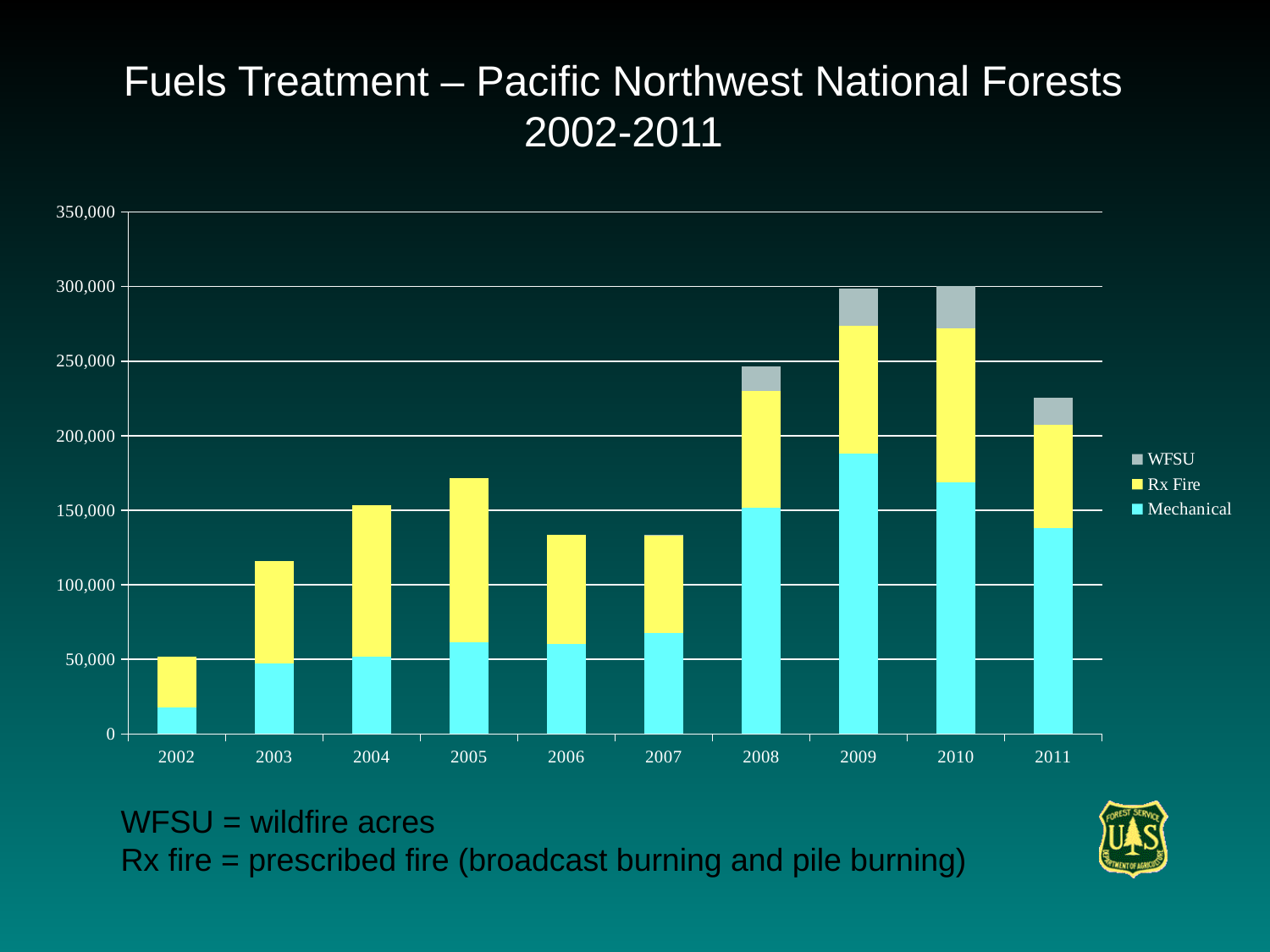
Is the total bar for 2008 greater or less than 200,000? greater Which year has the lowest total treated acres in the chart? 2002 Which series in the legend is shown in yellow? Rx Fire Which year has the larger total bar, 2008 or 2011? 2008 How many series does the chart's legend list? 3 Which year has the larger total bar, 2005 or 2006? 2005 How many years are shown along the x axis of the chart? 10 Is the Mechanical value for 2009 greater or less than 150,000? greater What kind of chart is shown on the slide? Stacked bar chart Is the total bar for 2002 greater or less than 100,000? less Which year has the largest Mechanical segment in the chart? 2009